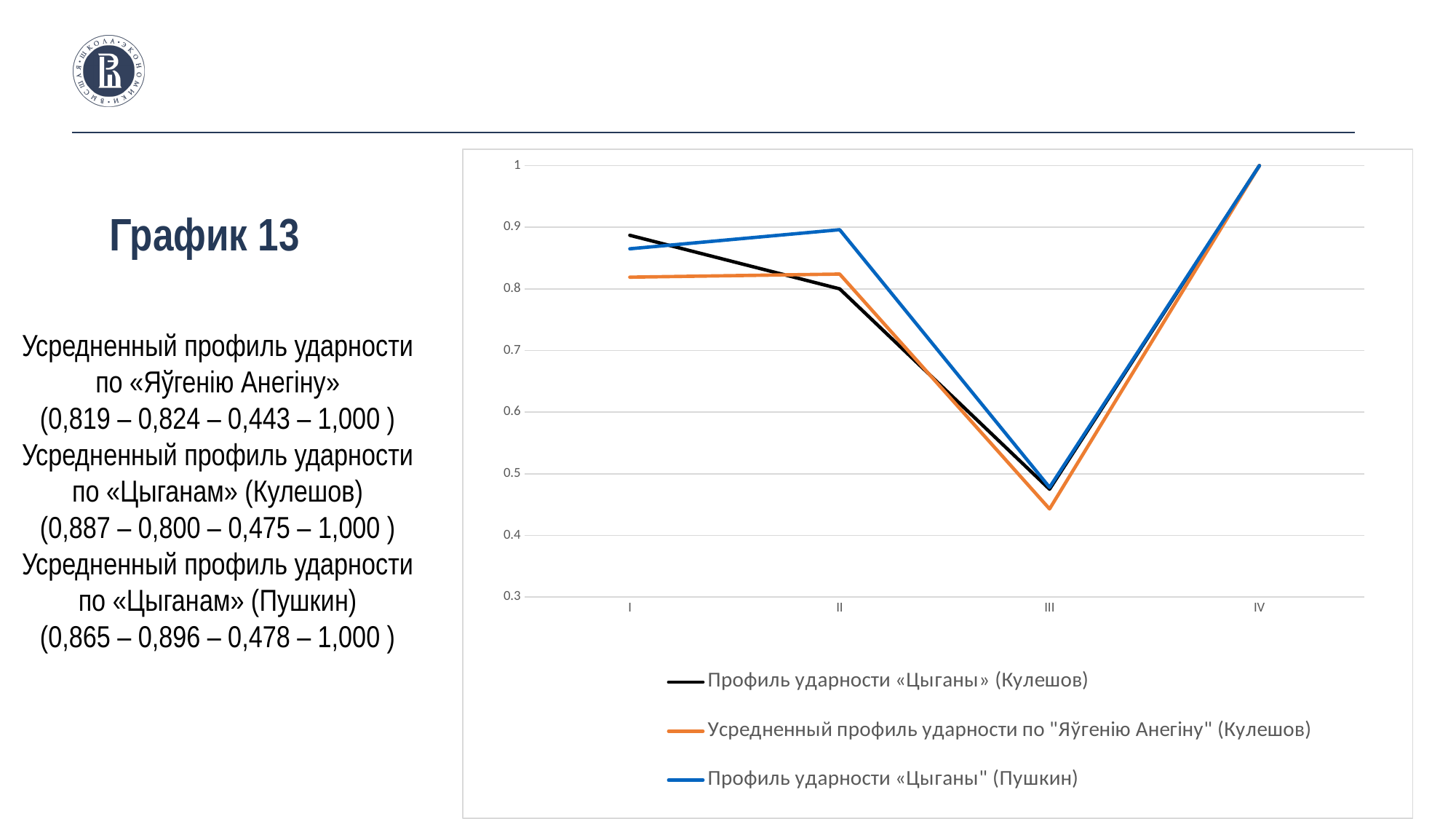
Is the value of «Усредненный профиль ударности по "Яўгенію Анегіну" (Кулешов)» at II greater or less than 0.7? greater At I, which is higher: «Профиль ударности «Цыганы» (Кулешов)» or «Профиль ударности «Цыганы" (Пушкин)»? Профиль ударности «Цыганы» (Кулешов) How many series does the legend list? 3 Do the values of all three series rise or fall from II to III? fall What is the value of the series «Профиль ударности «Цыганы» (Кулешов)» at IV? 1 Which series has the lowest value at III? Усредненный профиль ударности по "Яўгенію Анегіну" (Кулешов) Is the value of «Профиль ударности «Цыганы" (Пушкин)» at III greater or less than 0.5? less How many points are plotted along the x axis for each series? 4 Which series has the highest value at II? Профиль ударности «Цыганы" (Пушкин) What kind of chart is shown on the slide? line chart Is the value of «Профиль ударности «Цыганы» (Кулешов)» at I greater or less than 0.8? greater What colour is the line for «Профиль ударности «Цыганы" (Пушкин)»? blue